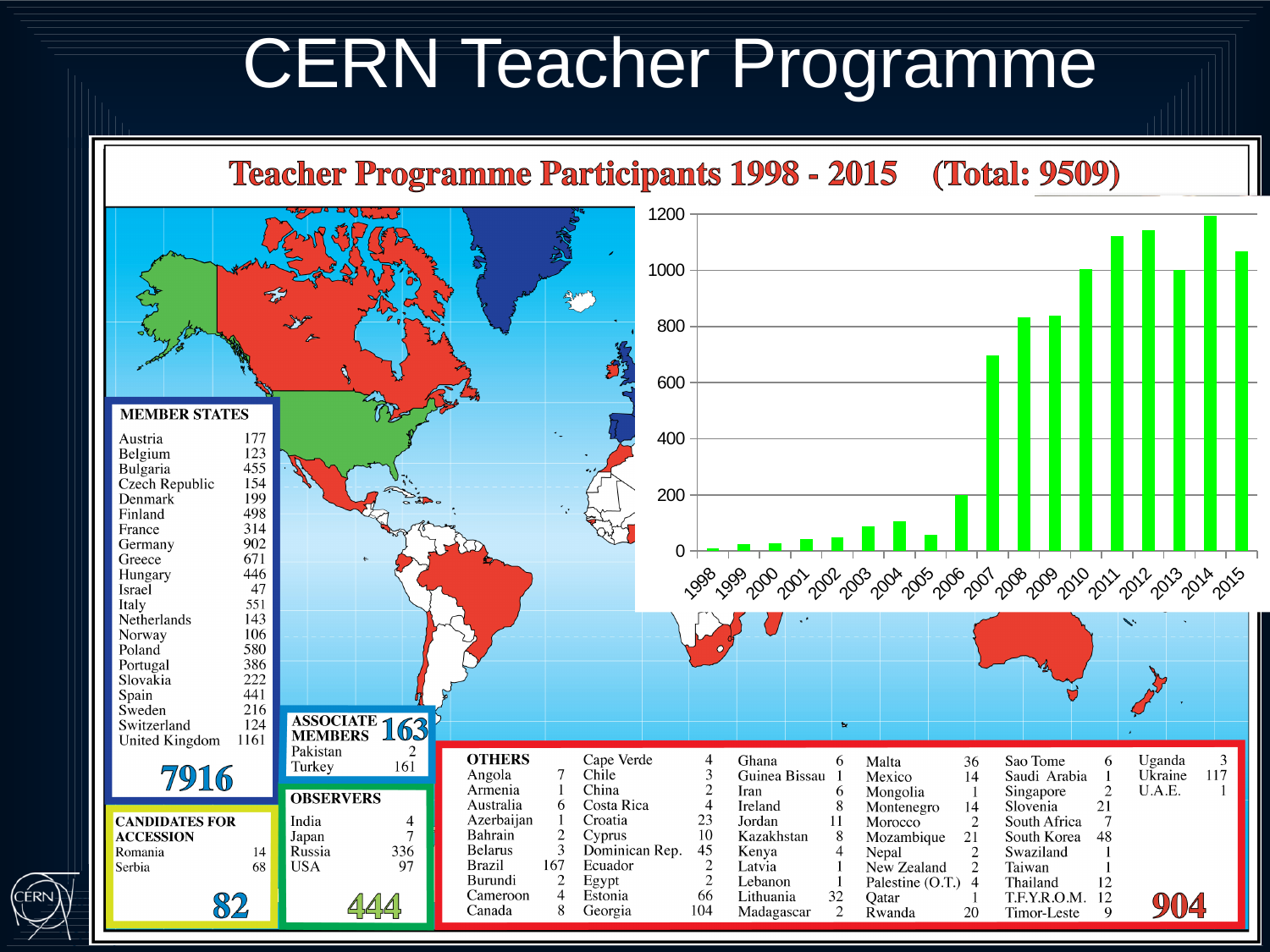
What kind of chart is shown on the slide? bar chart Which year has more participants, 2007 or 2008? 2008 Which year has the lowest number of participants? 1998 Do the participant numbers generally rise or fall from 1998 to 2015? rise Which year has more participants, 2004 or 2005? 2004 Is the value for 2011 greater or less than 1000? greater How many years are plotted on the x axis of the chart? 18 Which year has the highest number of participants? 2014 Is the value for 2003 greater or less than 200? less Is the value for 2009 greater or less than 800? greater What is the title of the chart? Teacher Programme Participants 1998 - 2015 (Total: 9509)